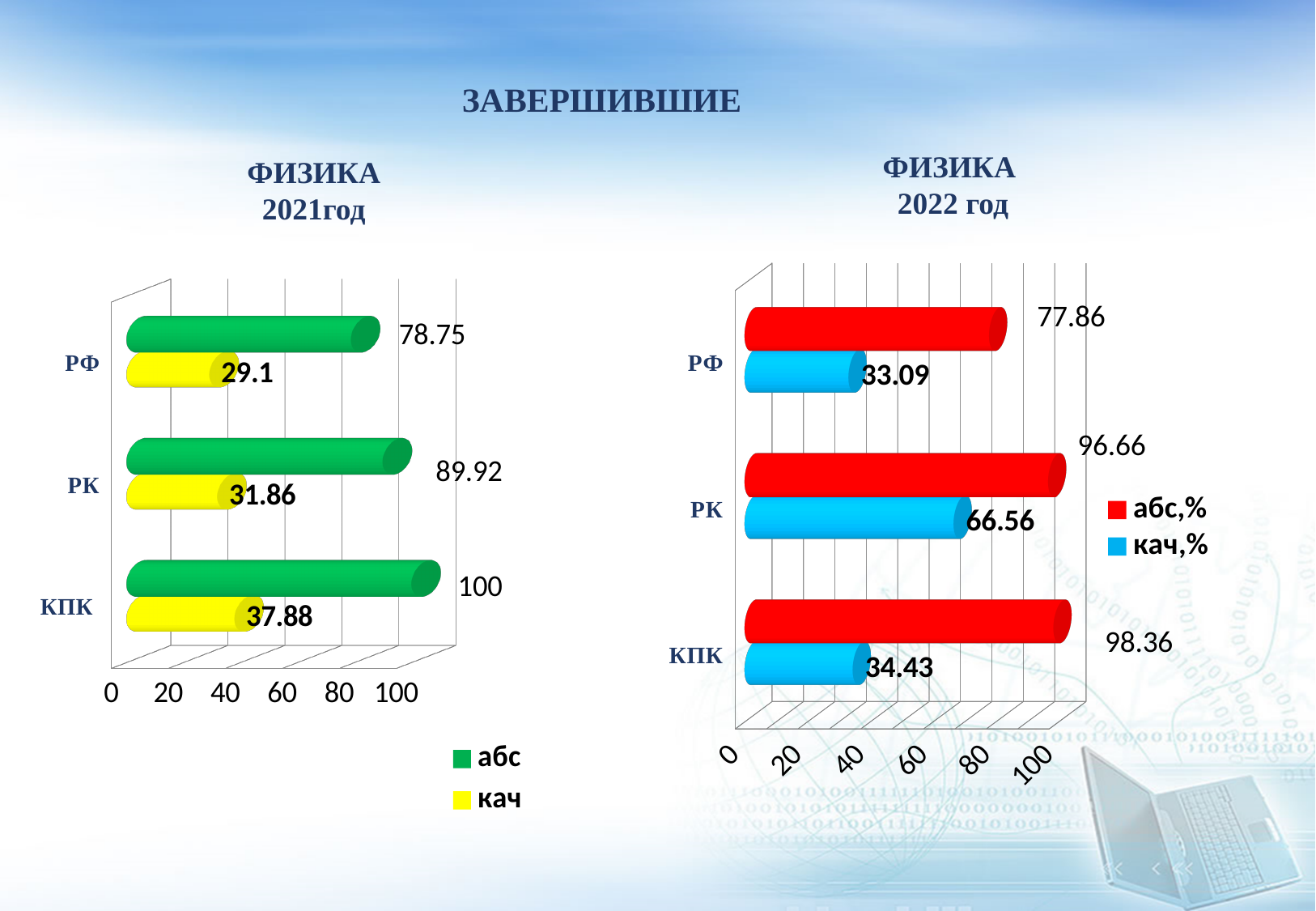
In the ФИЗИКА 2022 год chart, which category has the highest кач,% value? РК In the ФИЗИКА 2021год chart, which category has the lowest кач value? РФ In the ФИЗИКА 2022 год chart, what is the difference between the абс,% and кач,% values for РФ? 44.77 What type of chart is the ФИЗИКА 2022 год chart? Bar chart In the ФИЗИКА 2021год chart, what is the кач value for КПК? 37.88 In the ФИЗИКА 2022 год chart, which is larger: the абс,% value for РК or for КПК? КПК In the ФИЗИКА 2021год chart, what is the абс value for РК? 89.92 In the ФИЗИКА 2021год chart, how many categories are shown? 3 In the ФИЗИКА 2022 год chart, what is the кач,% value for РК? 66.56 In the ФИЗИКА 2021год chart, what is the difference between the абс values for КПК and РФ? 21.25 In the ФИЗИКА 2022 год chart, what is the абс,% value for КПК? 98.36 In the ФИЗИКА 2021год chart, how many series does the legend list? 2